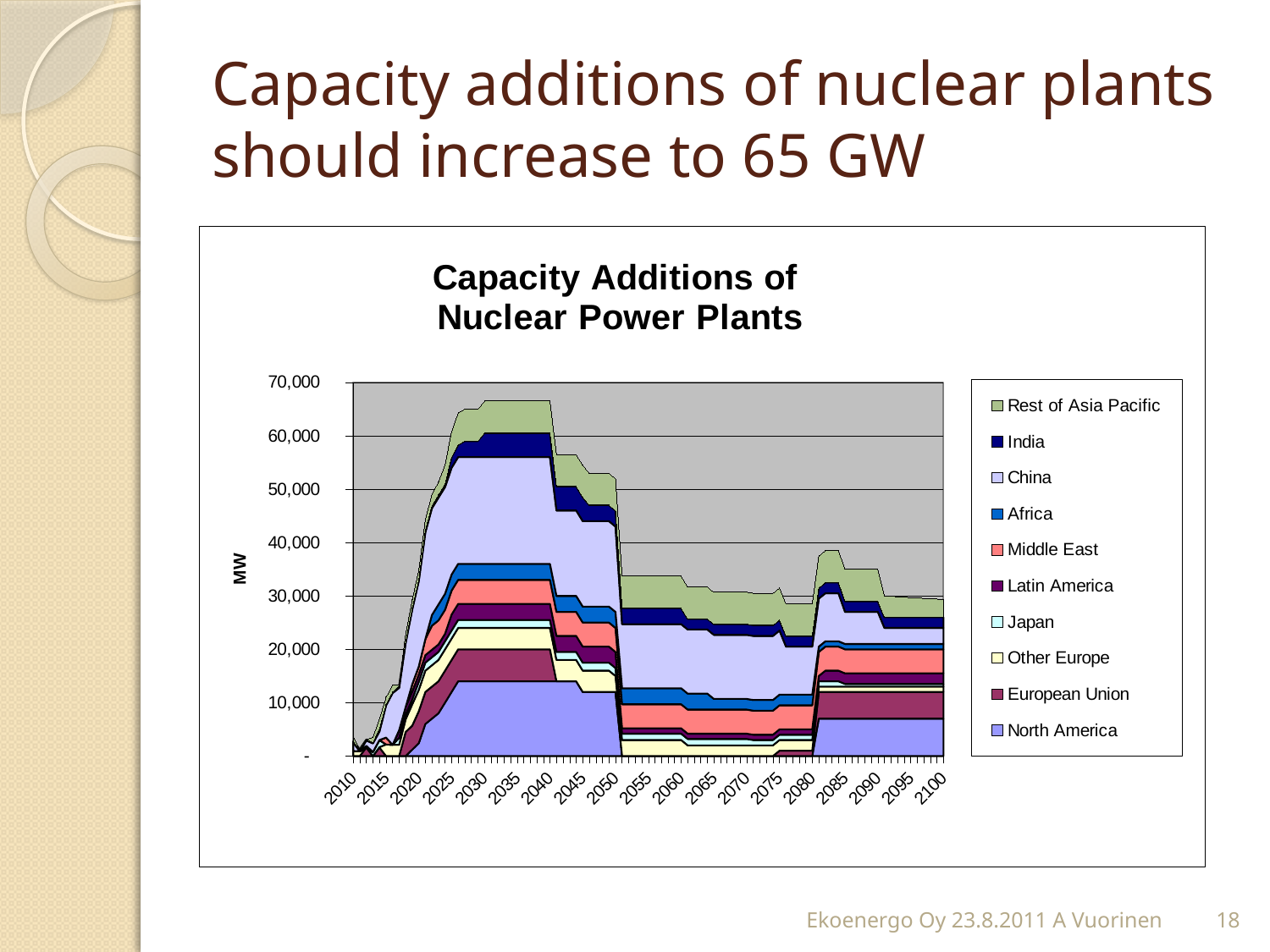
How many year labels are shown along the x axis? 19 Is the total capacity addition around 2085 greater or less than 40,000 MW? less Is the total capacity addition around 2045 greater or less than 50,000 MW? greater Around 2030, which series contributes more capacity: China or India? China Do the total capacity additions rise or fall between 2040 and 2055? fall What is the label on the vertical axis? MW What is the title of the chart? Capacity Additions of Nuclear Power Plants What kind of chart is shown on the slide? stacked area chart Do the total capacity additions rise or fall between 2010 and 2030? rise How many series does the legend list? 10 Is the total capacity addition around 2035 greater or less than 60,000 MW? greater